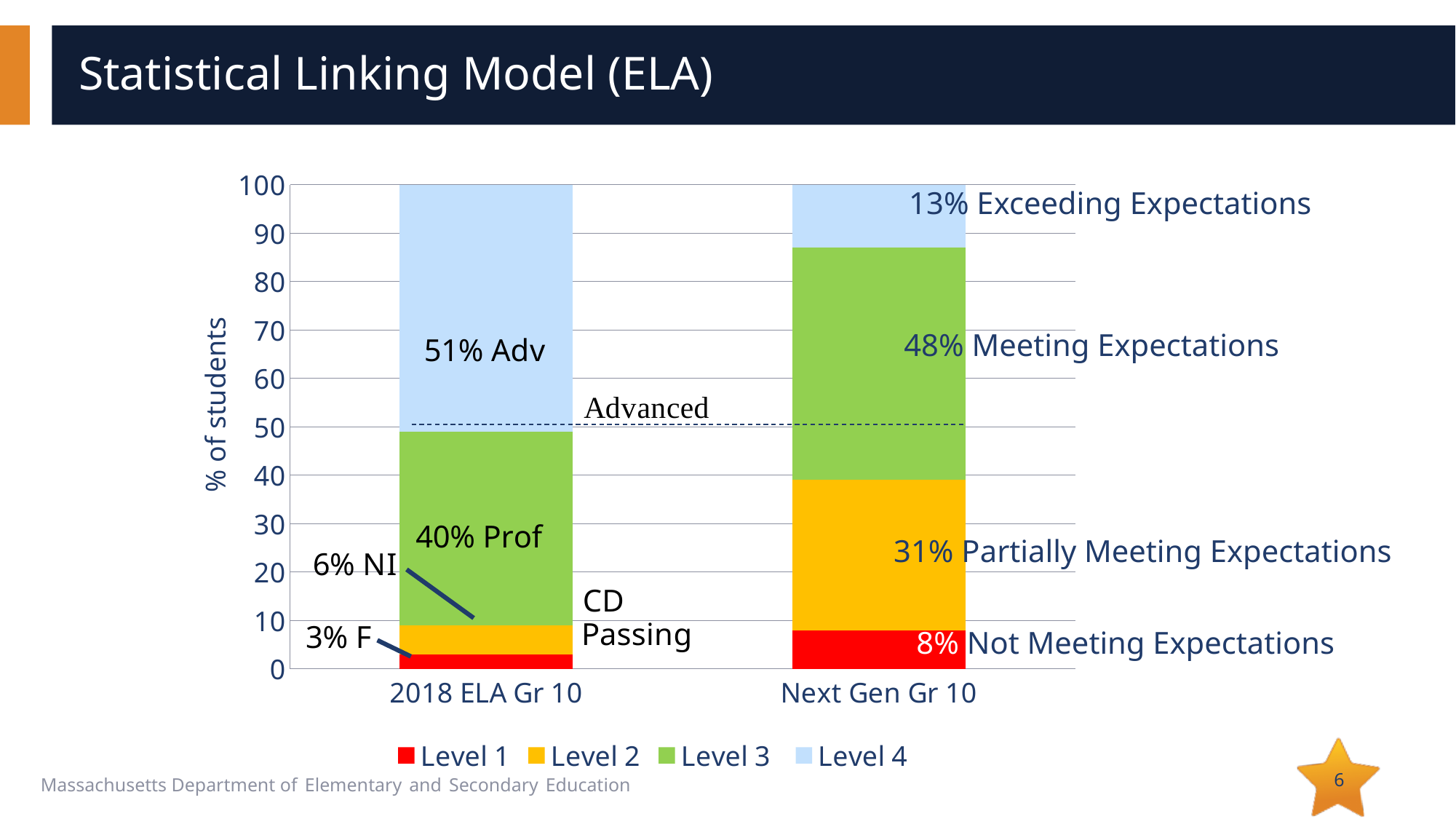
What type of chart is shown on the slide? stacked bar chart How many series does the legend list? 4 What is the difference between the Level 1 share in Next Gen Gr 10 (Not Meeting Expectations) and in 2018 ELA Gr 10 (F)? 5% Which segment is the largest in the 2018 ELA Gr 10 bar? 51% Adv (Level 4) What percentage of students were Needs Improvement (NI) in 2018 ELA Gr 10? 6% How many bars (categories) are plotted on the x axis? 2 Which segment is the smallest in the Next Gen Gr 10 bar? 8% Not Meeting Expectations (Level 1) What percentage of students are Partially Meeting Expectations in Next Gen Gr 10? 31% What percentage of students were Advanced (Adv) in 2018 ELA Gr 10? 51% What is the label of the y axis? % of students Which is larger: the Advanced share in 2018 ELA Gr 10 or the Exceeding Expectations share in Next Gen Gr 10? Advanced share in 2018 ELA Gr 10 (51%) What percentage of students are Meeting Expectations in Next Gen Gr 10? 48%